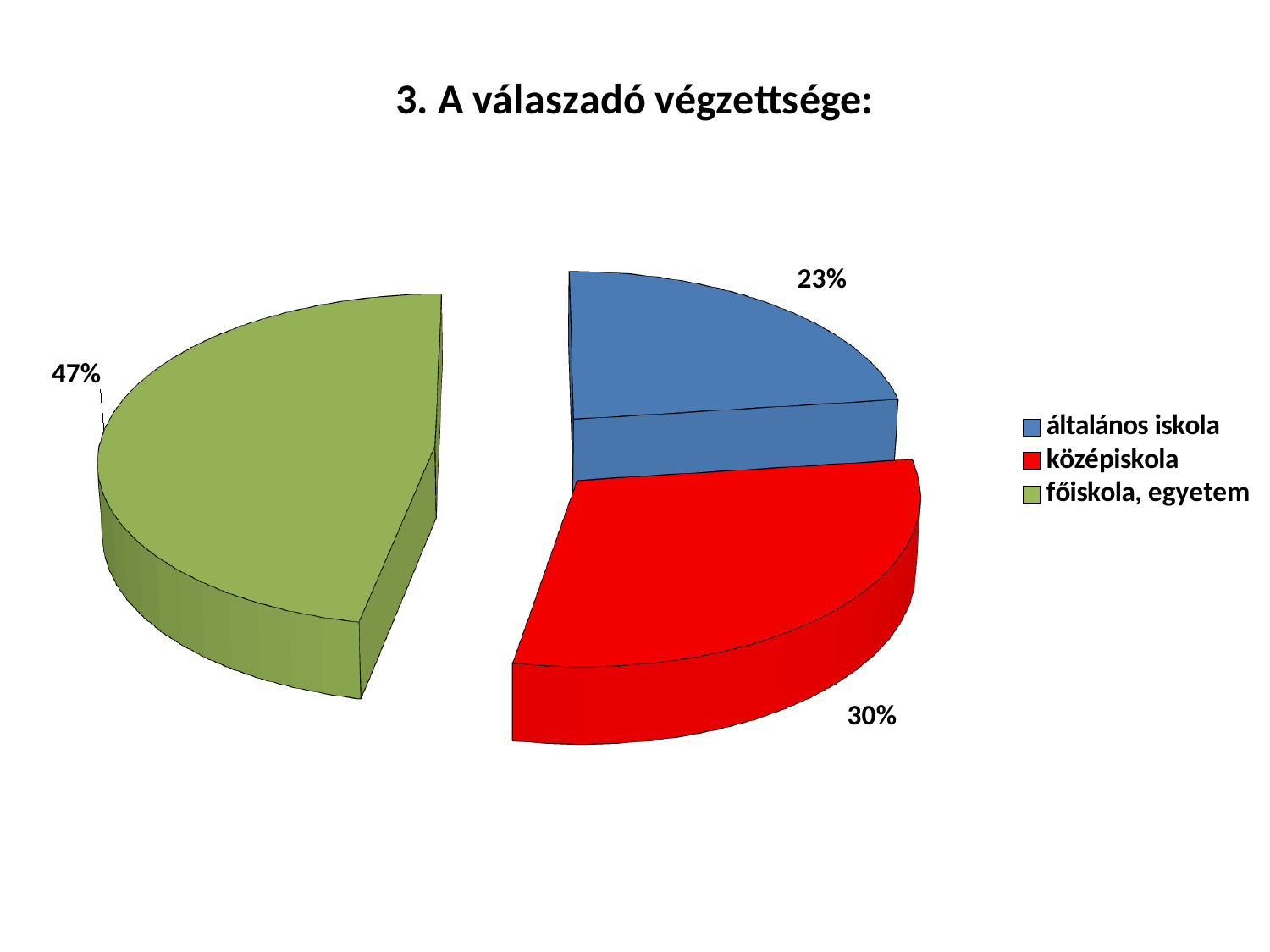
Which has a larger share, 'középiskola' or 'általános iskola'? középiskola What share of the pie does 'főiskola, egyetem' have? 47% What kind of chart is shown on the slide? pie chart Which category has the largest share of the pie? főiskola, egyetem What is the difference in percentage points between 'középiskola' and 'általános iskola'? 7 What colour is the slice for 'középiskola'? red What share of the pie does 'középiskola' have? 30% Which category has the smallest share of the pie? általános iskola How many categories does the pie chart show? 3 What share of the pie does 'általános iskola' have? 23% What is the difference in percentage points between 'főiskola, egyetem' and 'középiskola'? 17 What is the title of the chart? 3. A válaszadó végzettsége: